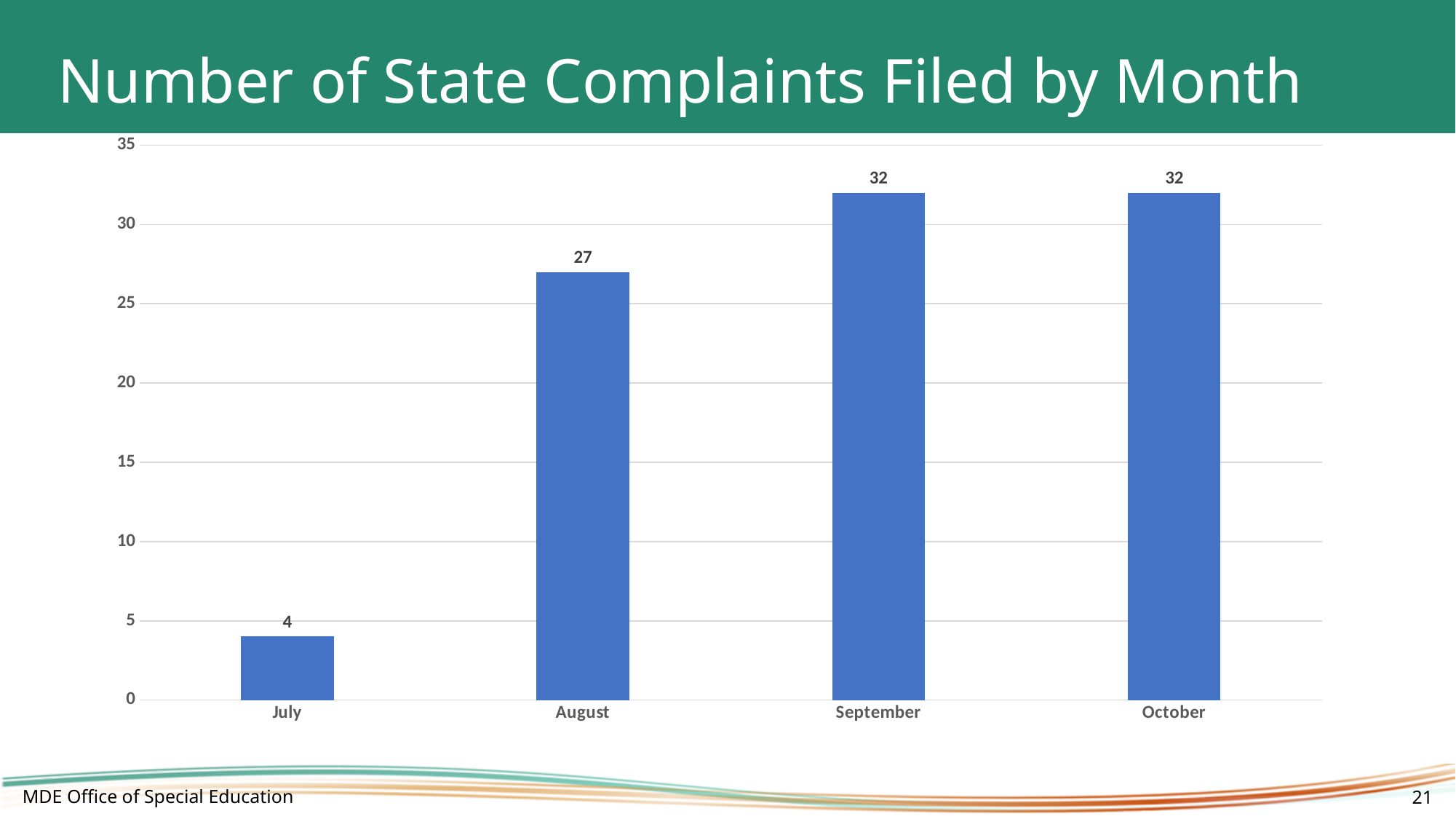
What kind of chart is shown on the slide? Bar chart How many state complaints were filed in August? 27 How many state complaints were filed in September? 32 What is the difference between the number of complaints filed in September and in August? 5 Which month had more complaints filed, July or August? August What is the title of the chart on the slide? Number of State Complaints Filed by Month How many state complaints were filed in July? 4 How many state complaints were filed in October? 32 Which month has the lowest number of state complaints filed? July Is the value for August greater or less than 25? greater What is the difference between the number of complaints filed in August and in July? 23 How many months are shown on the chart? 4